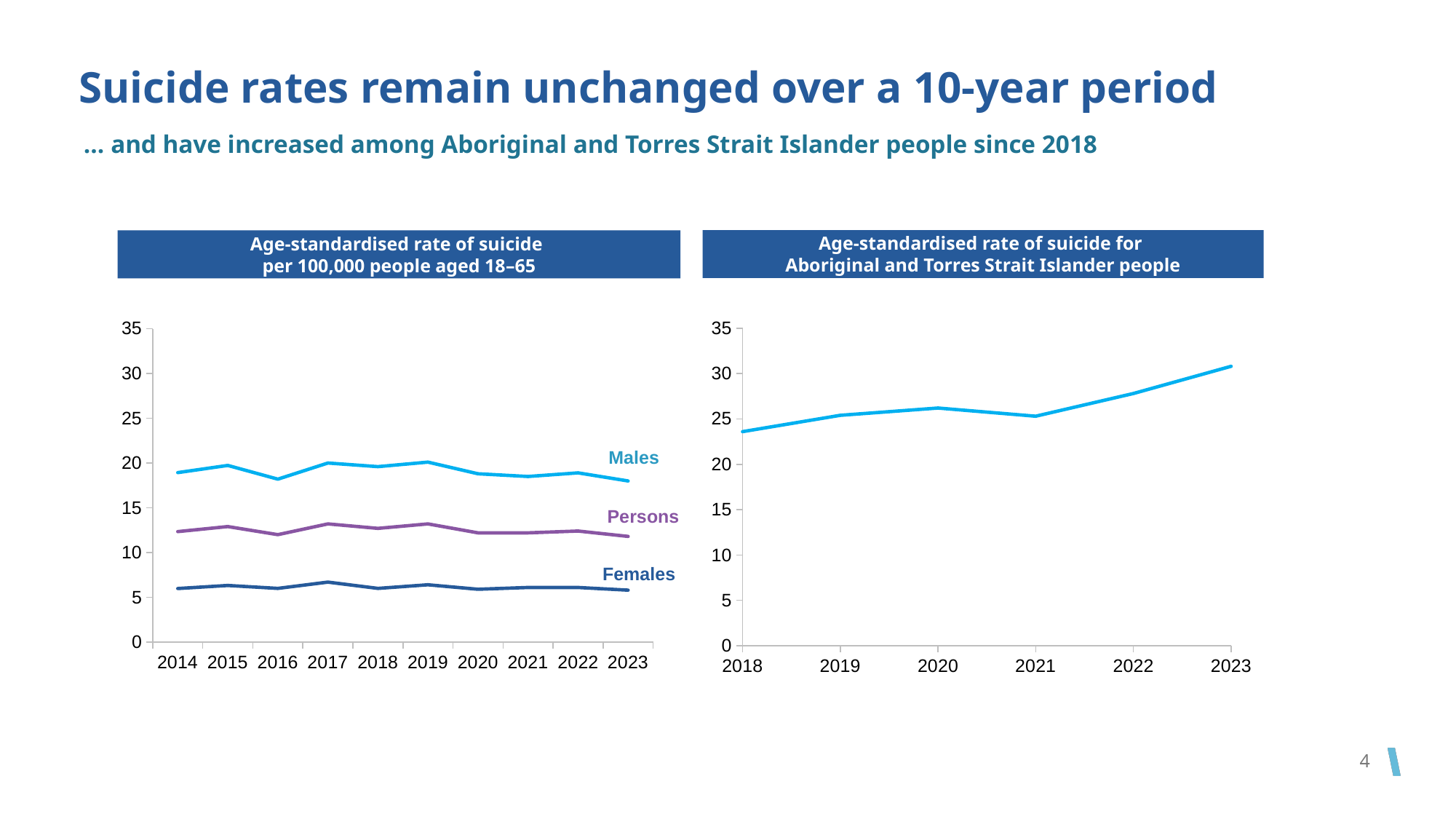
How many series are plotted on the 'Age-standardised rate of suicide per 100,000 people aged 18–65' chart? 3 On the 'Age-standardised rate of suicide for Aboriginal and Torres Strait Islander people' chart, is the value for 2023 greater or less than 30? greater On the 'Age-standardised rate of suicide per 100,000 people aged 18–65' chart, which is larger in 2023: Males or Persons? Males On the 'Age-standardised rate of suicide per 100,000 people aged 18–65' chart, which series has the lowest values throughout? Females What kind of chart is the 'Age-standardised rate of suicide for Aboriginal and Torres Strait Islander people' chart? line chart On the 'Age-standardised rate of suicide for Aboriginal and Torres Strait Islander people' chart, which year has the highest value? 2023 On the 'Age-standardised rate of suicide per 100,000 people aged 18–65' chart, is the value for Males in 2014 greater or less than 15? greater On the 'Age-standardised rate of suicide per 100,000 people aged 18–65' chart, which series has the highest values throughout? Males What kind of chart is the 'Age-standardised rate of suicide per 100,000 people aged 18–65' chart? line chart How many years are shown on the x axis of the 'Age-standardised rate of suicide per 100,000 people aged 18–65' chart? 10 On the 'Age-standardised rate of suicide per 100,000 people aged 18–65' chart, is the value for Females in 2017 greater or less than 10? less How many years are shown on the x axis of the 'Age-standardised rate of suicide for Aboriginal and Torres Strait Islander people' chart? 6